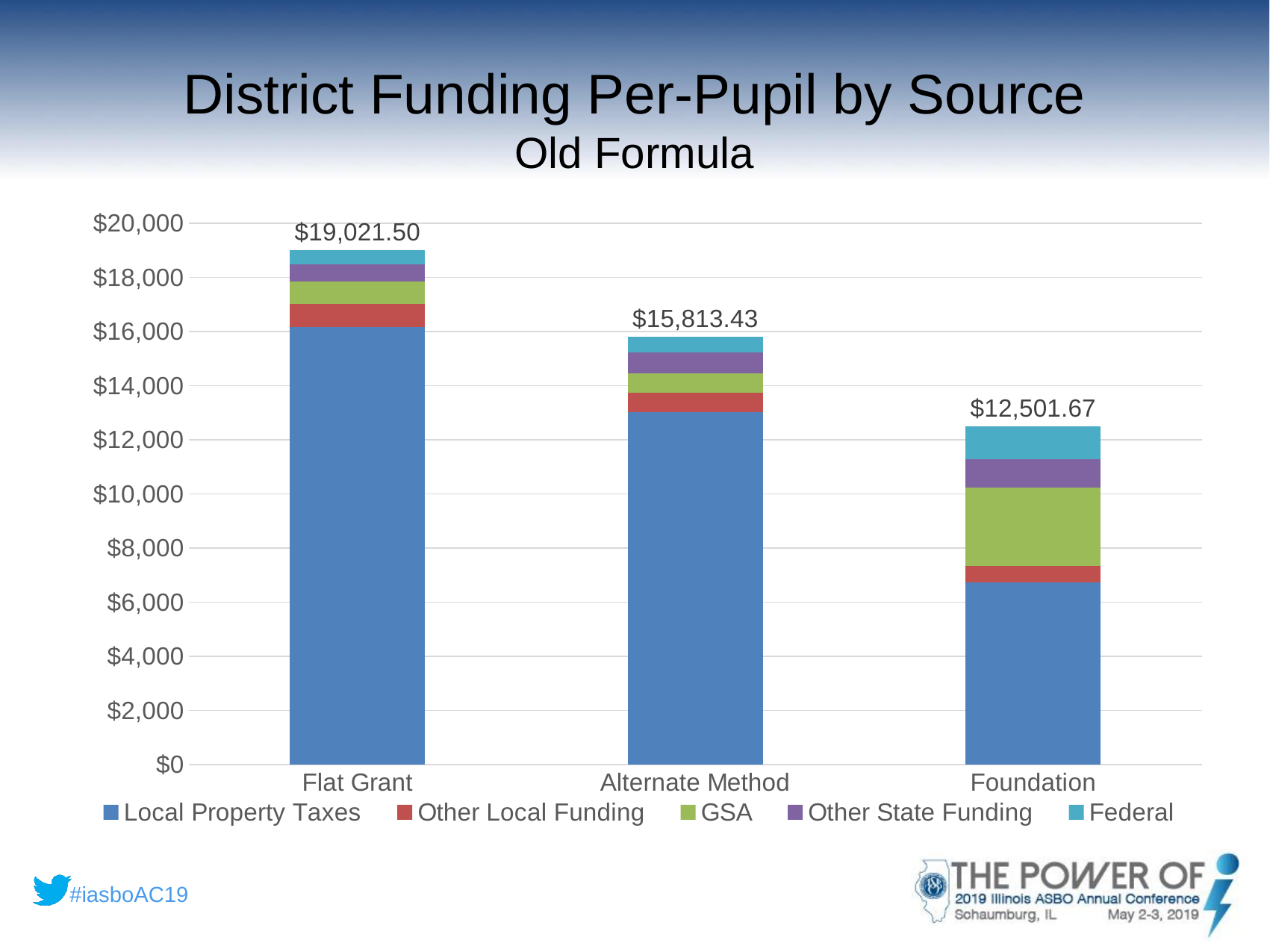
What is the difference between the Flat Grant total and the Alternate Method total? $3,208.07 What is the total per-pupil funding shown for the Alternate Method bar? $15,813.43 What is the total per-pupil funding shown for the Flat Grant bar? $19,021.50 Which has a larger total per-pupil funding, Alternate Method or Foundation? Alternate Method Is the Local Property Taxes value for Foundation greater or less than $8,000? less Which district type has the lowest total per-pupil funding? Foundation What is the difference between the Flat Grant total and the Foundation total? $6,519.83 Is the Local Property Taxes value for Flat Grant greater or less than $14,000? greater Do the total per-pupil funding values rise or fall from left to right across the categories? fall How many series does the legend list? 5 Which district type has the highest total per-pupil funding? Flat Grant What is the total per-pupil funding shown for the Foundation bar? $12,501.67